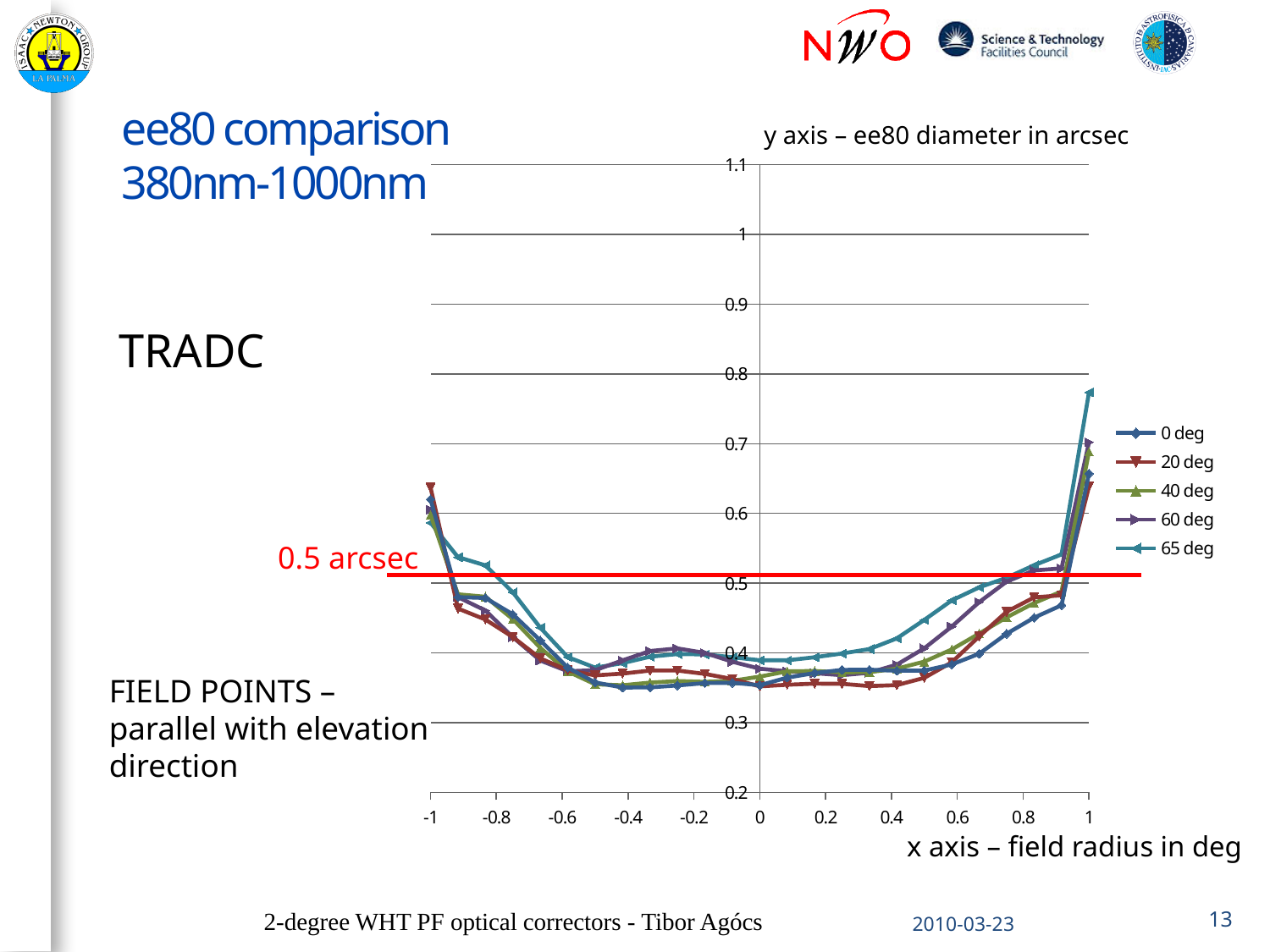
Is the value of the 65 deg series at x = 1 greater or less than 0.7? greater Do the values rise or fall as x goes from 0.6 to 1? rise At x = 1, which series has the larger value, 65 deg or 20 deg? 65 deg Is the value of the 20 deg series at x = -1 greater or less than 0.6? greater How many series does the legend list? 5 Which series does the legend list last? 65 deg Is the value of the 0 deg series at x = 0.6 greater or less than 0.5? less What kind of chart is shown on the slide? line chart Do the values rise or fall as x goes from -1 to -0.6? fall What quantity does the y axis represent, according to the slide? ee80 diameter in arcsec Which series has the highest value at x = 1? 65 deg